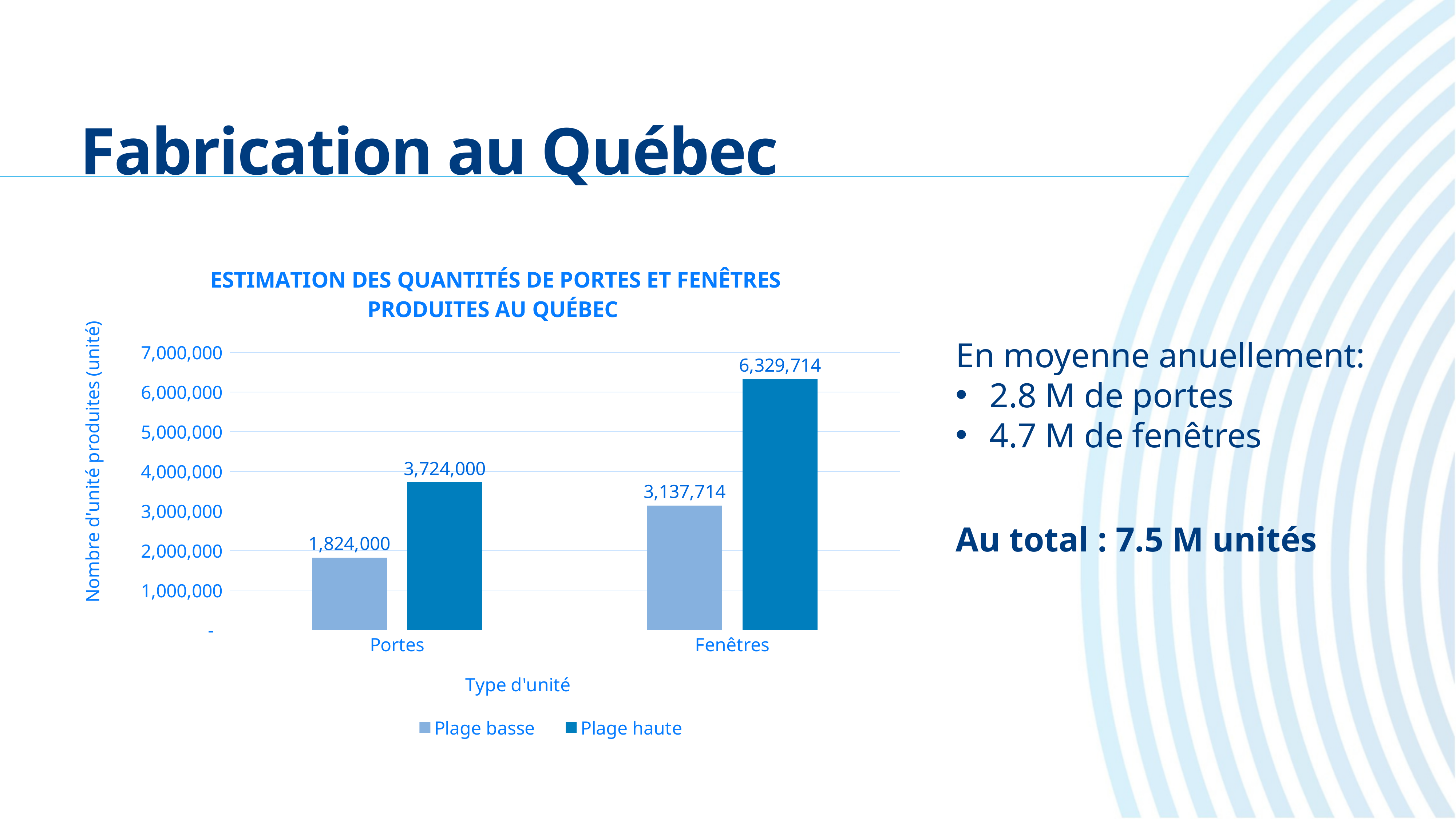
What is the difference between the Plage haute values for Fenêtres and Portes? 2,605,714 How many categories are shown on the x axis? 2 Which category has the highest Plage haute value? Fenêtres What is the Plage haute value for Fenêtres? 6,329,714 What is the Plage haute value for Portes? 3,724,000 Which category has the lowest Plage basse value? Portes What is the Plage basse value for Fenêtres? 3,137,714 What is the Plage basse value for Portes? 1,824,000 What kind of chart is shown on the slide? Bar chart How many series does the legend list? 2 Which is larger: the Plage basse value for Fenêtres or the Plage haute value for Portes? Plage haute for Portes What is the difference between the Plage haute and Plage basse values for Portes? 1,900,000